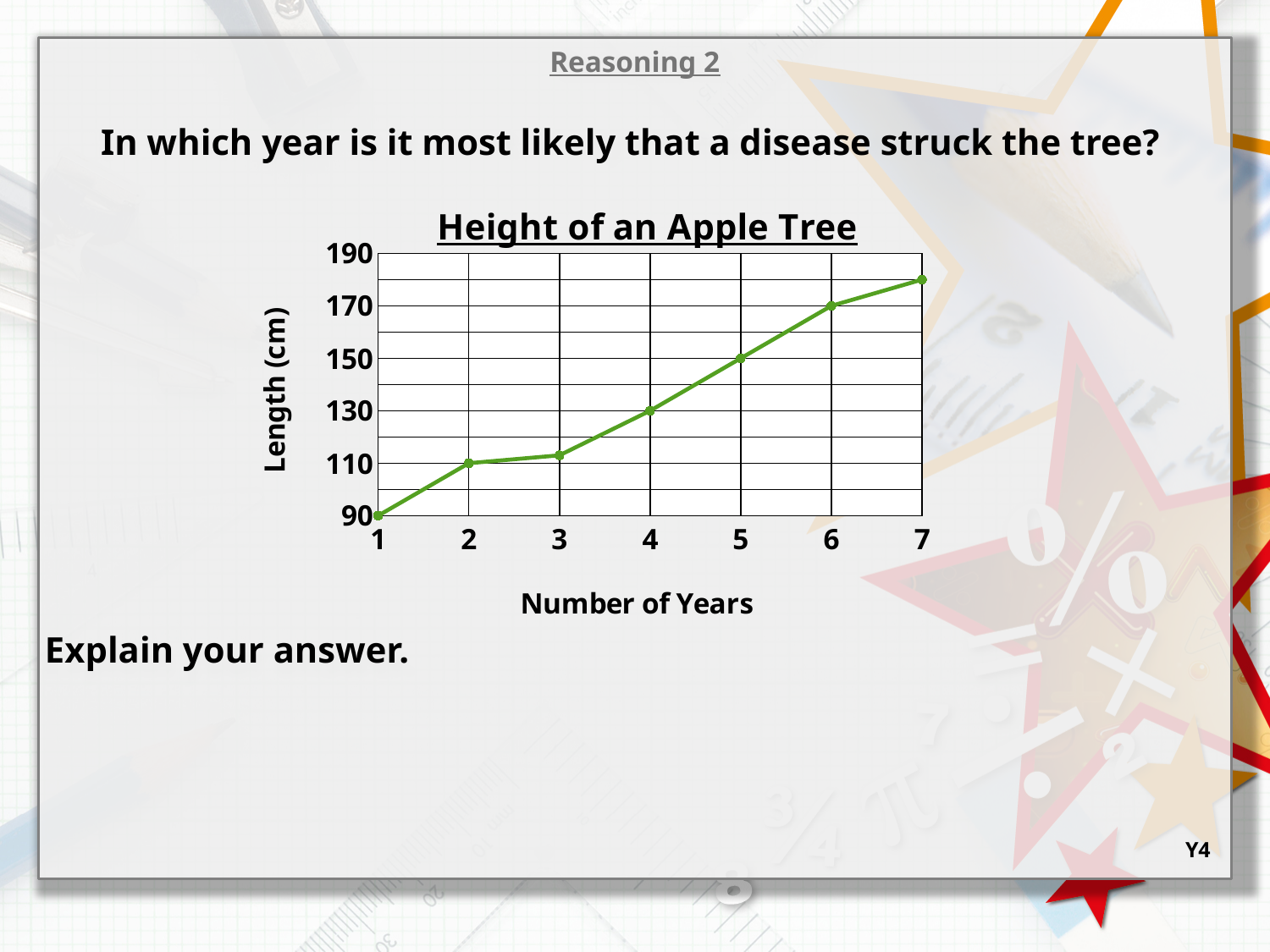
Is the value for year 7 greater or less than 170? greater How many years are plotted on the chart? 7 What is the label of the vertical axis? Length (cm) What is the height of the apple tree at year 6? 170 What is the height of the apple tree at year 2? 110 What type of chart is shown on the slide? Line chart In which year is the tree's height the lowest? 1 What is the title of the chart? Height of an Apple Tree What is the height of the apple tree at year 1? 90 How much taller is the tree at year 6 than at year 2? 60 In which year is the tree's height the greatest? 7 What is the height of the apple tree at year 4? 130